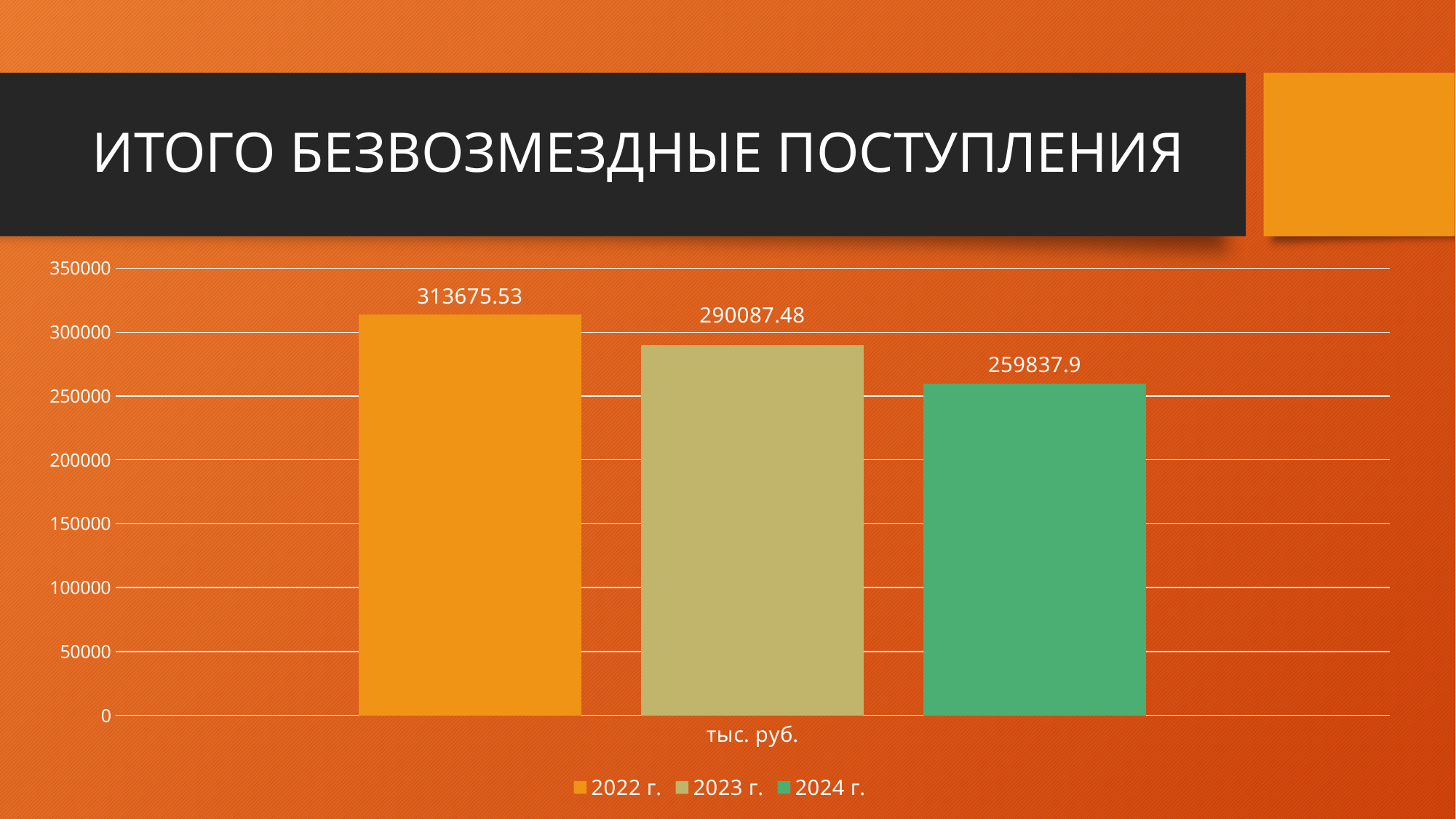
What is the difference between the values for 2023 г. and 2024 г.? 30249.58 How many series does the legend list? 3 What is the difference between the values for 2022 г. and 2023 г.? 23588.05 What is the value for 2024 г.? 259837.9 Which year has the highest value? 2022 г. What is the value for 2023 г.? 290087.48 Which is larger, the value for 2023 г. or the value for 2024 г.? 2023 г. What is the value for 2022 г.? 313675.53 Do the values rise or fall from 2022 г. to 2024 г.? fall Is the value for 2024 г. greater or less than 250000? greater Which year has the lowest value? 2024 г. What kind of chart is shown on the slide? bar chart